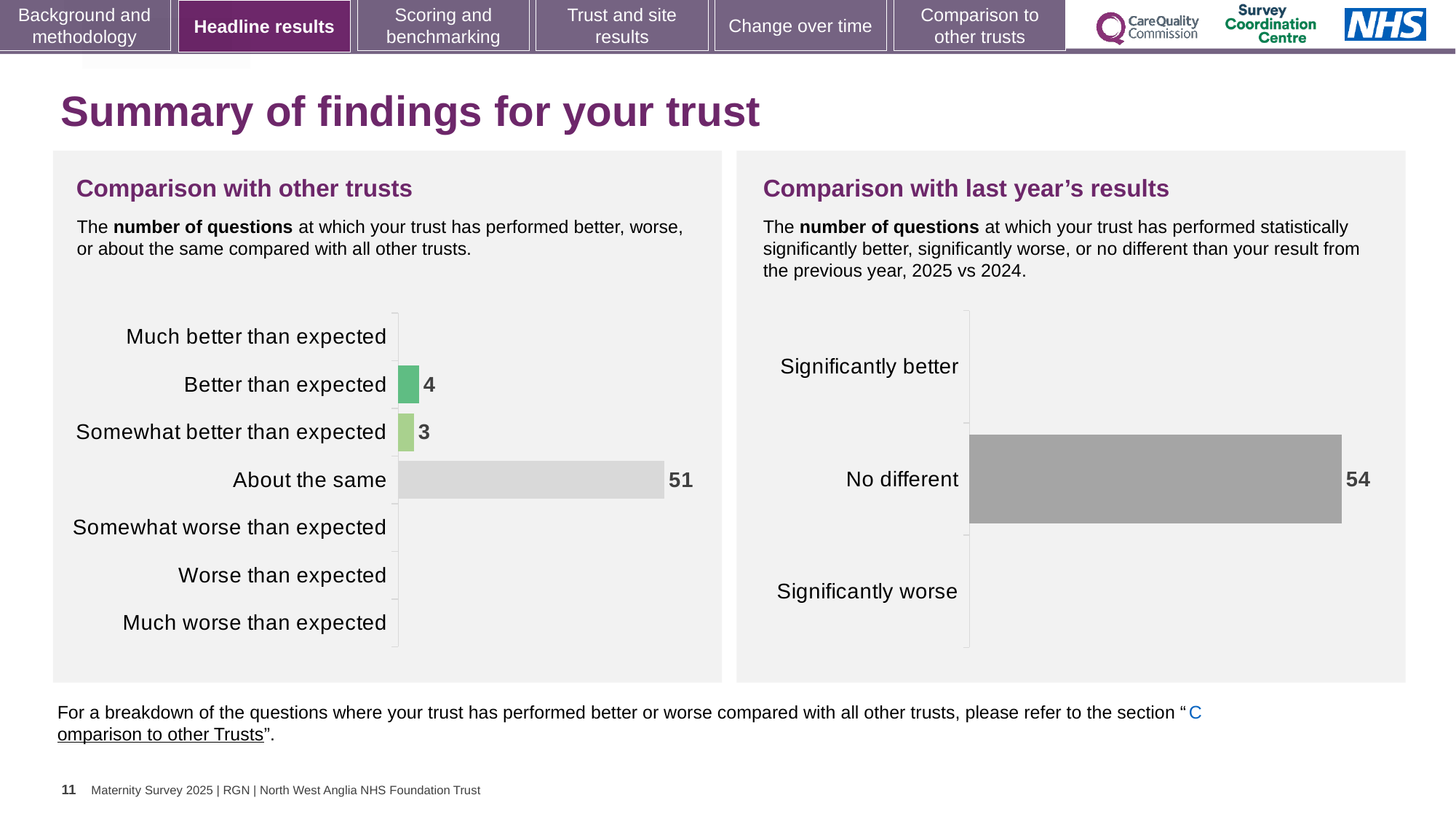
How many categories are listed on the y axis of the 'Comparison with last year's results' chart? 3 In the 'Comparison with other trusts' chart, what is the value for 'Somewhat better than expected'? 3 What kind of chart is the 'Comparison with other trusts' chart? Bar chart In the 'Comparison with last year's results' chart, what is the value for 'No different'? 54 What is the title of the chart on the right side of the slide? Comparison with last year's results In the 'Comparison with other trusts' chart, which category has the highest value? About the same In the 'Comparison with other trusts' chart, which is larger: 'Better than expected' or 'Somewhat better than expected'? Better than expected In the 'Comparison with other trusts' chart, what is the value for 'About the same'? 51 How many categories are listed on the y axis of the 'Comparison with other trusts' chart? 7 In the 'Comparison with other trusts' chart, what is the difference between 'About the same' and 'Better than expected'? 47 In the 'Comparison with other trusts' chart, what is the value for 'Better than expected'? 4 In the 'Comparison with last year's results' chart, which category has the highest value? No different